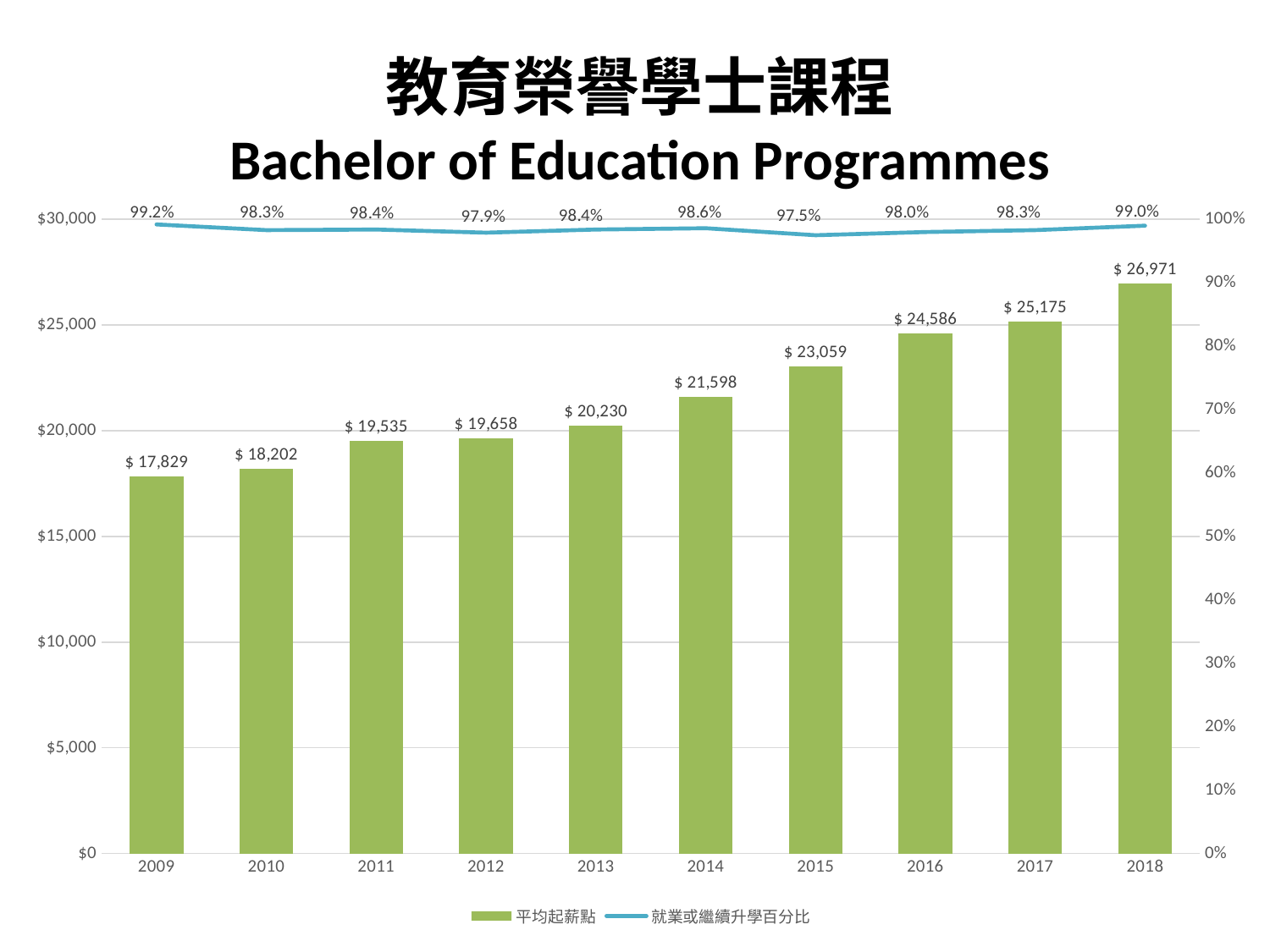
What is the average starting salary (平均起薪點) shown for 2012? $ 19,658 Which year has the lowest employment or further study percentage (就業或繼續升學百分比)? 2015 Do the average starting salary bars rise or fall from 2009 to 2018? Rise What is the average starting salary (平均起薪點) shown for 2018? $ 26,971 Which year has the highest average starting salary (平均起薪點)? 2018 What is the difference between the average starting salary in 2018 and in 2009? $ 9,142 What is the employment or further study percentage (就業或繼續升學百分比) shown for 2015? 97.5% How many years are shown on the x axis of the chart? 10 Which year has the lowest average starting salary (平均起薪點)? 2009 What kind of chart is used to show the average starting salary (平均起薪點)? Bar chart How many series does the legend list? 2 Which is larger, the average starting salary in 2016 or in 2017? 2017